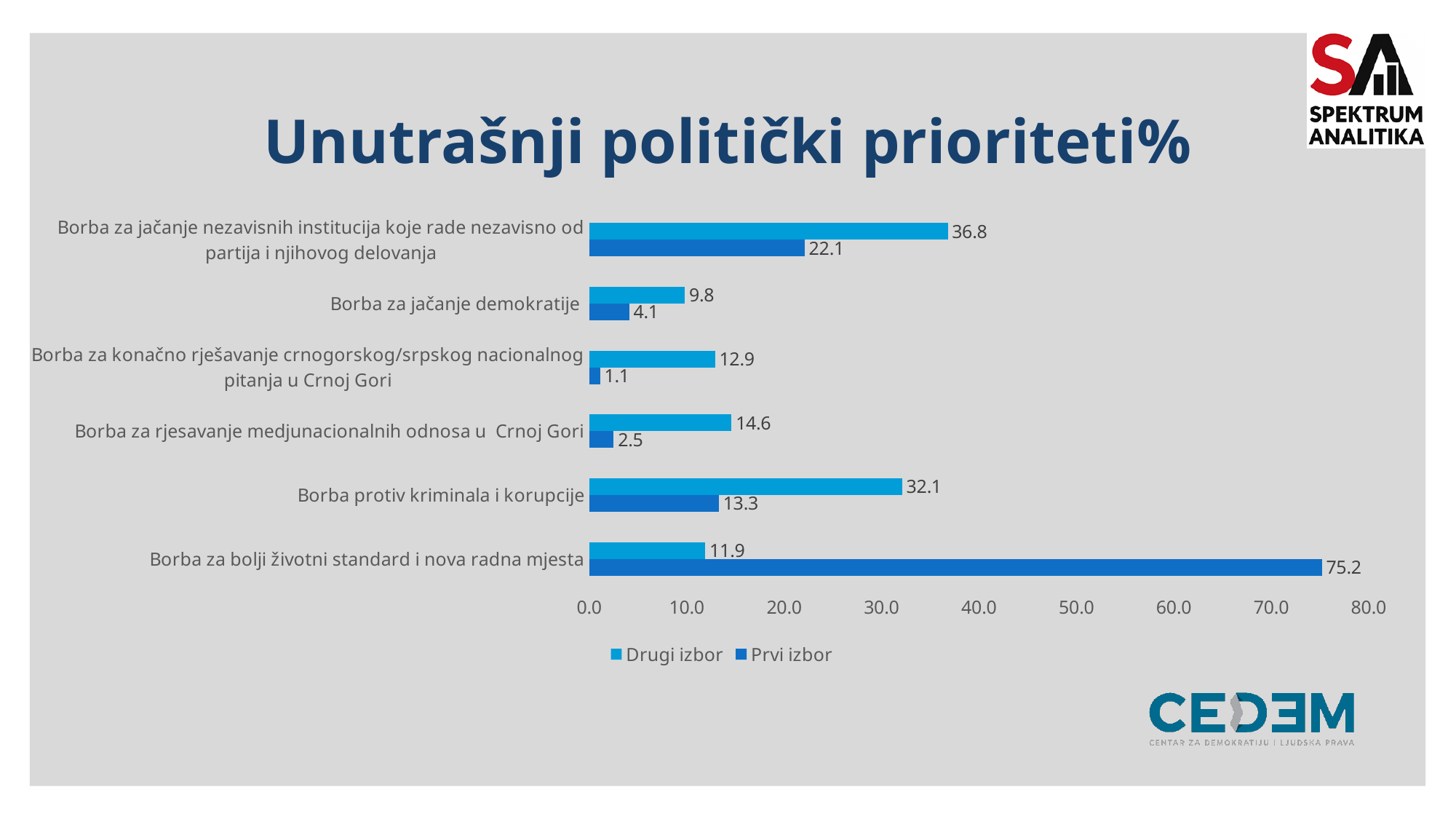
What kind of chart is shown on the slide? Bar chart How many series does the legend list? 2 What is the 'Drugi izbor' value for 'Borba protiv kriminala i korupcije'? 32.1 Which is larger for 'Borba protiv kriminala i korupcije': the 'Prvi izbor' value or the 'Drugi izbor' value? Drugi izbor Which category has the lowest 'Prvi izbor' value? Borba za konačno rješavanje crnogorskog/srpskog nacionalnog pitanja u Crnoj Gori How many categories are shown on the chart? 6 What is the title of the chart? Unutrašnji politički prioriteti% Which category has the highest 'Drugi izbor' value? Borba za jačanje nezavisnih institucija koje rade nezavisno od partija i njihovog delovanja What is the 'Prvi izbor' value for 'Borba za jačanje demokratije'? 4.1 What is the 'Prvi izbor' value for 'Borba za bolji životni standard i nova radna mjesta'? 75.2 What is the difference between the 'Prvi izbor' and 'Drugi izbor' values for 'Borba za bolji životni standard i nova radna mjesta'? 63.3 What is the 'Drugi izbor' value for 'Borba za rjesavanje medjunacionalnih odnosa u Crnoj Gori'? 14.6